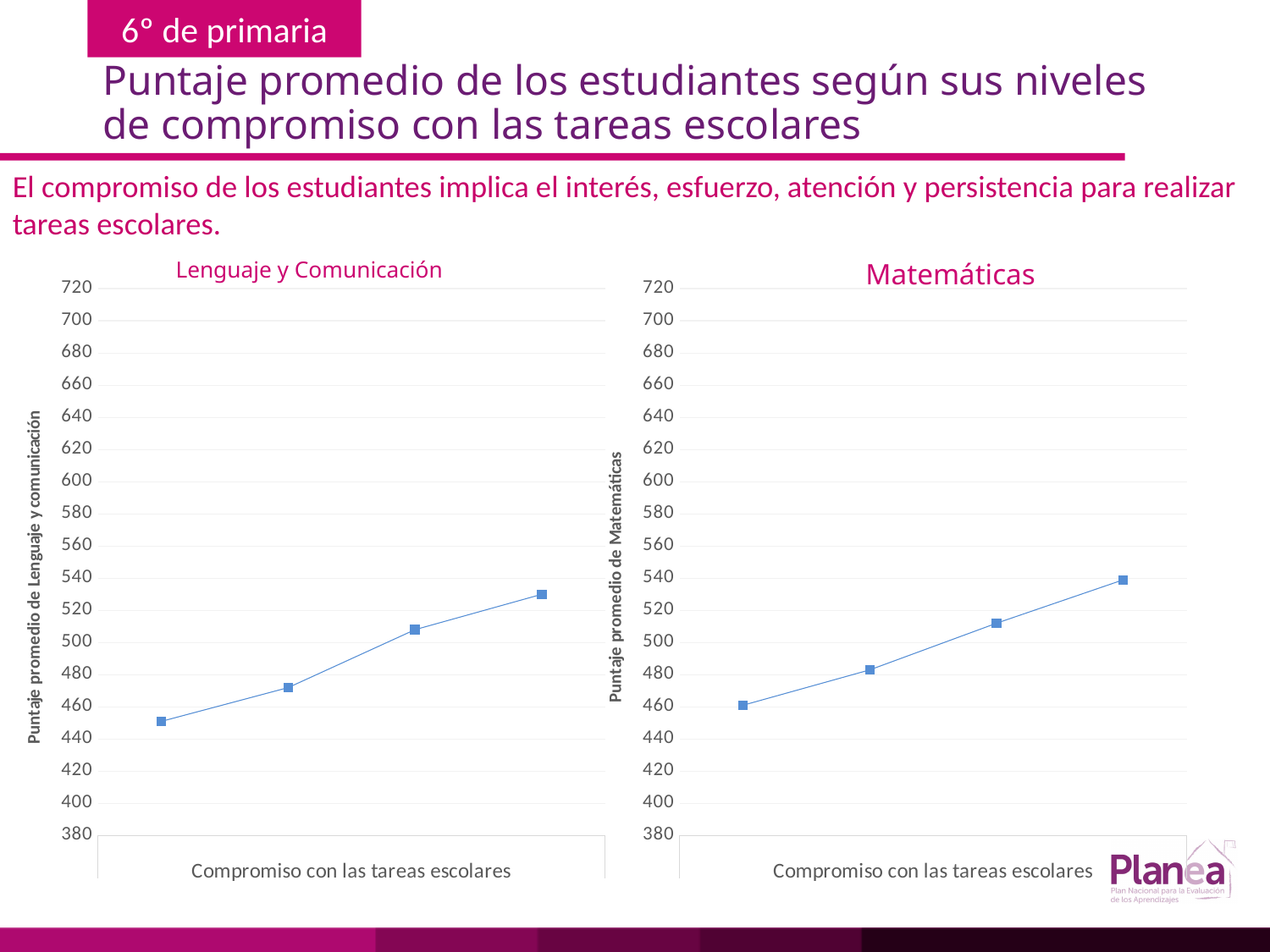
What is the y-axis title of the Lenguaje y Comunicación chart? Puntaje promedio de Lenguaje y comunicación What kind of chart is the Lenguaje y Comunicación chart? line chart What is the x-axis label of the Matemáticas chart? Compromiso con las tareas escolares In the Lenguaje y Comunicación chart, is the value of the first (leftmost) point greater or less than 460? less In the Matemáticas chart, is the value of the second point greater or less than 500? less How many data points are plotted in the Matemáticas chart? 4 In the Matemáticas chart, do the values rise or fall from left to right along the x axis? rise In the Lenguaje y Comunicación chart, is the value of the last (rightmost) point greater or less than 520? greater In the Lenguaje y Comunicación chart, do the values rise or fall from left to right along the x axis? rise